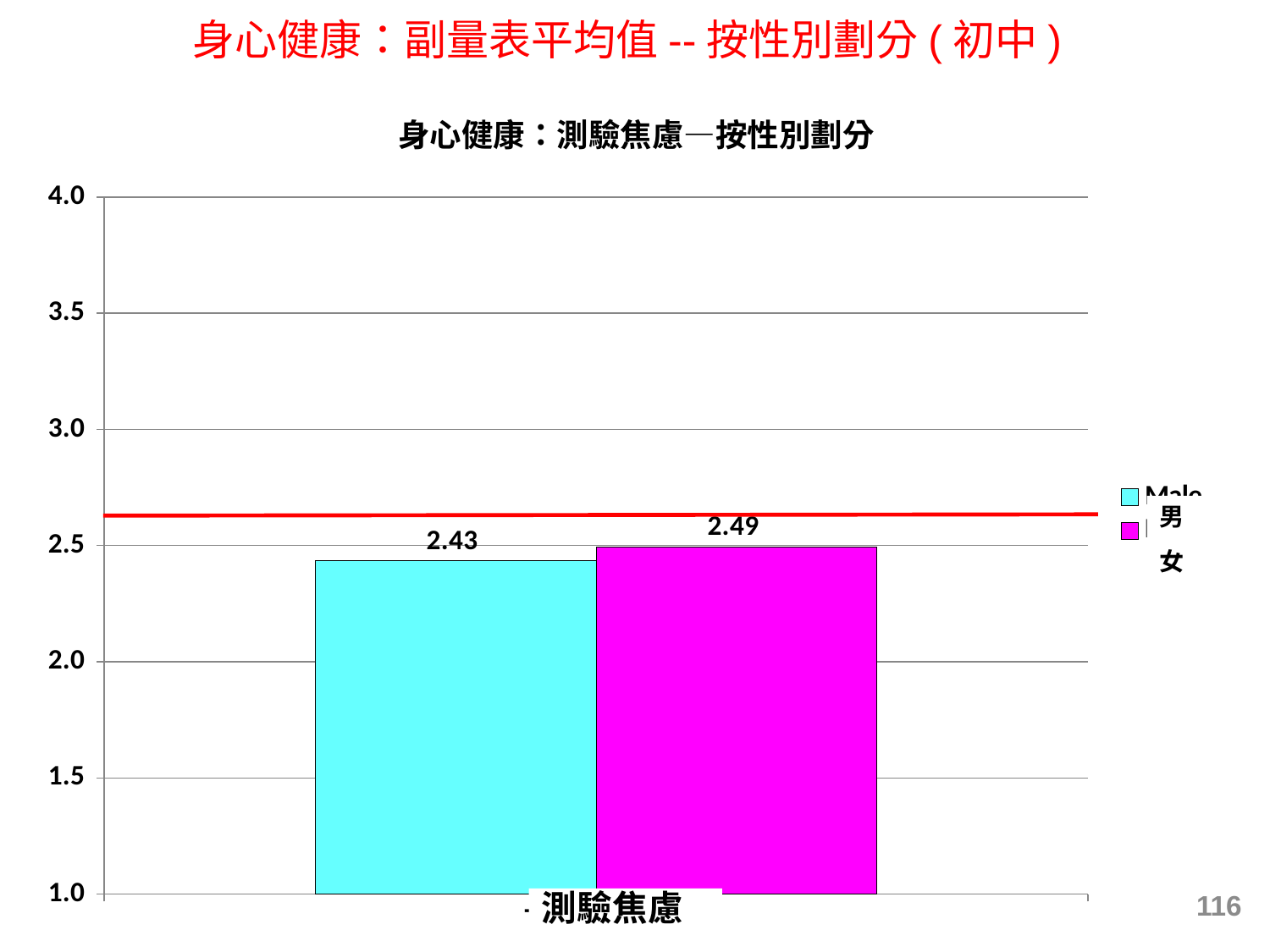
Is the value for 女 greater or less than 2.0? greater How many series does the legend list? 2 What is the value for 男 (male) in the 測驗焦慮 chart? 2.43 What is the difference between the 女 value and the 男 value for 測驗焦慮? 0.06 What is the category label shown on the x axis of the chart? 測驗焦慮 What is the value for 女 (female) in the 測驗焦慮 chart? 2.49 What colour is the bar for 女 (female)? magenta Which group has the lowest value in the chart? 男 Which group has the higher value for 測驗焦慮, 男 or 女? 女 Is the value for 男 greater or less than 2.5? less What kind of chart is shown on the slide? bar chart How many bars are plotted in the chart? 2